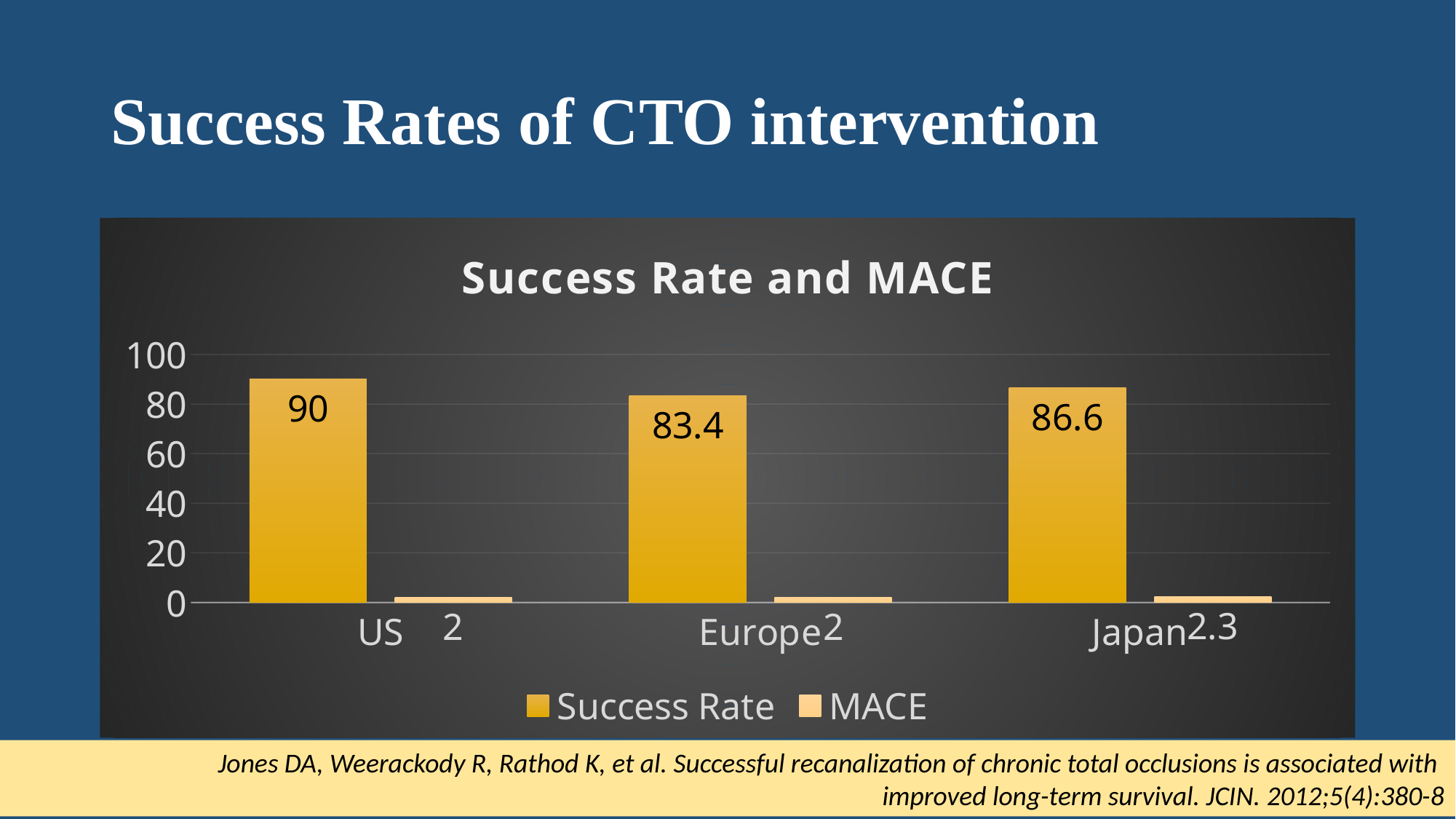
Which region has the highest Success Rate? US What is the title of the chart? Success Rate and MACE What is the difference between the Success Rate for the US and for Europe? 6.6 How many regions are shown on the x axis? 3 What kind of chart is shown on the slide? Bar chart What is the Success Rate value for Europe? 83.4 How many series does the legend list? 2 What is the MACE value for Japan? 2.3 Which region has the lowest Success Rate? Europe What is the difference between the Success Rate for Japan and for Europe? 3.2 Which is larger, the Success Rate for Japan or for Europe? Japan What is the Success Rate value for the US? 90